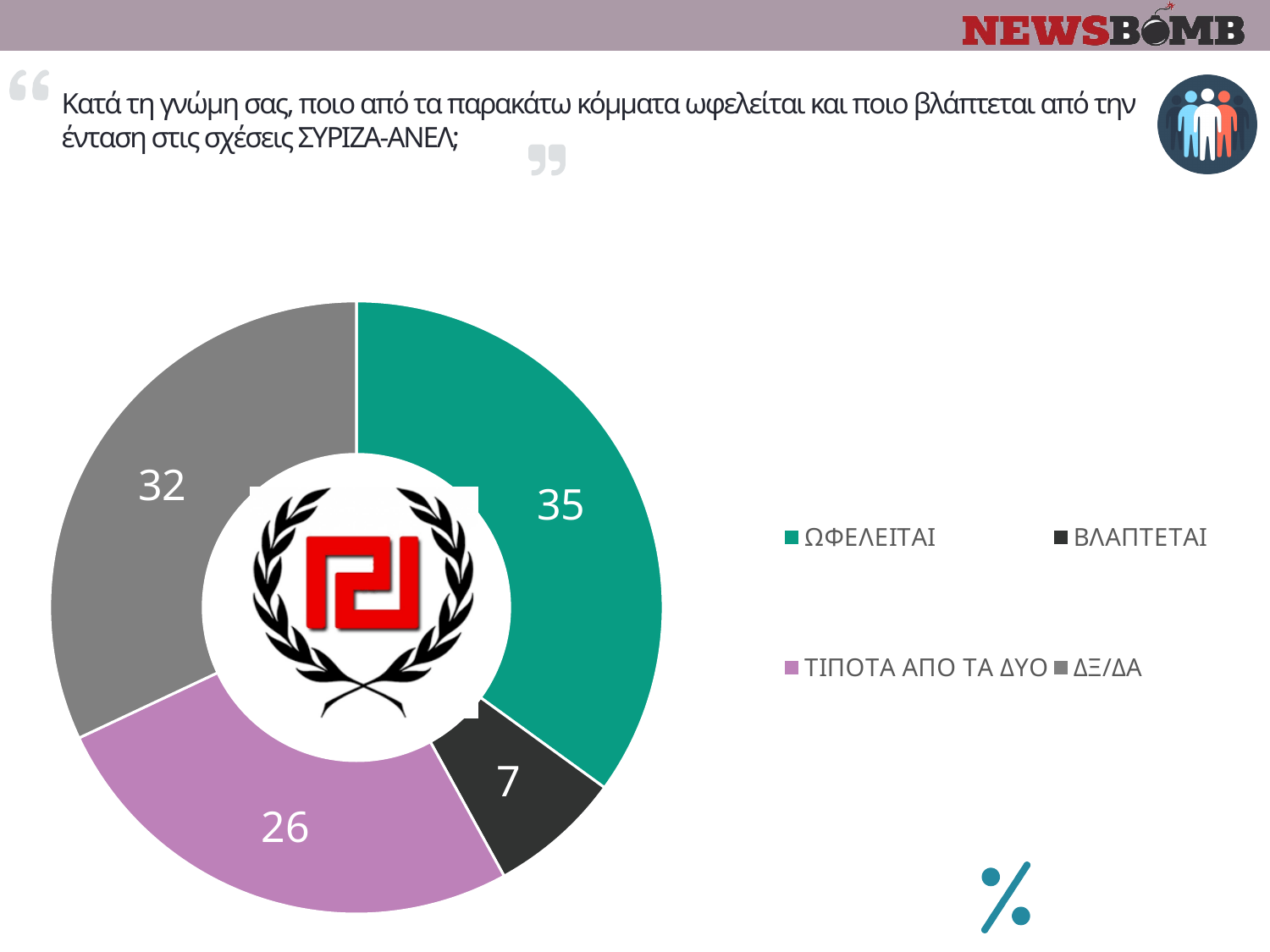
Which category has the largest value in the chart? ΩΦΕΛΕΙΤΑΙ Which is larger, the value for ΔΞ/ΔΑ or the value for ΤΙΠΟΤΑ ΑΠΟ ΤΑ ΔΥΟ? ΔΞ/ΔΑ Which category has the smallest value in the chart? ΒΛΑΠΤΕΤΑΙ What value is shown for ΩΦΕΛΕΙΤΑΙ in the chart? 35 What value is shown for ΒΛΑΠΤΕΤΑΙ in the chart? 7 What colour is the ΤΙΠΟΤΑ ΑΠΟ ΤΑ ΔΥΟ slice in the chart? purple What value is shown for ΔΞ/ΔΑ in the chart? 32 What value is shown for ΤΙΠΟΤΑ ΑΠΟ ΤΑ ΔΥΟ in the chart? 26 What is the difference between the values for ΔΞ/ΔΑ and ΤΙΠΟΤΑ ΑΠΟ ΤΑ ΔΥΟ? 6 How many categories does the chart show? 4 What kind of chart is shown on the slide? doughnut chart What is the difference between the values for ΩΦΕΛΕΙΤΑΙ and ΒΛΑΠΤΕΤΑΙ? 28